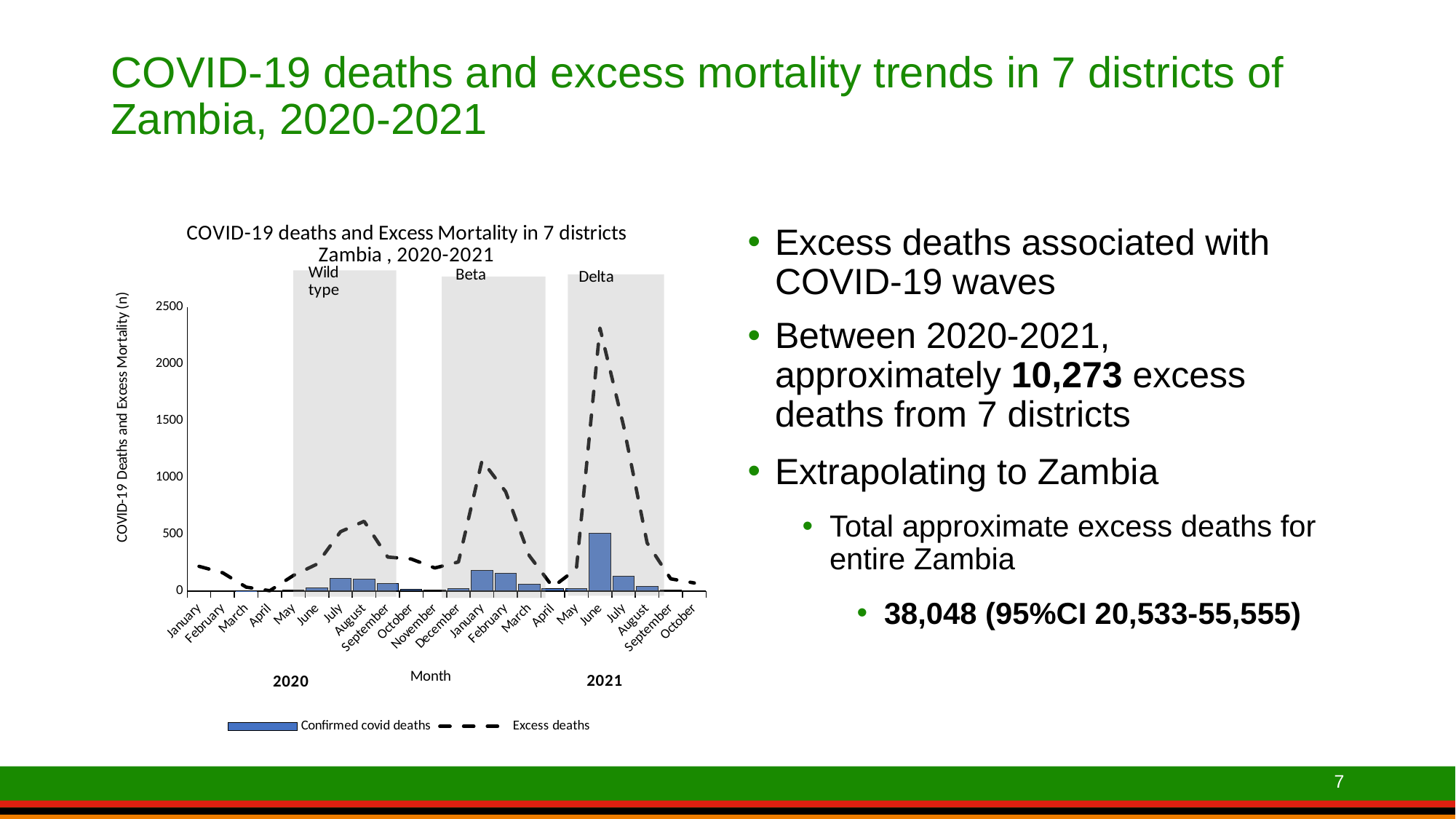
How many series does the chart legend list? 2 Which month has the larger Confirmed covid deaths bar, July 2020 or June 2021? June 2021 In which month does the Excess deaths line reach its peak? June 2021 Is the Excess deaths value for June 2021 greater or less than 2000? greater What are the two series named in the chart legend? Confirmed covid deaths and Excess deaths What kind of chart is shown on the slide? A combined bar and line chart Which month has the larger Excess deaths value, January 2021 or June 2021? June 2021 What are the three variant waves labelled by the shaded regions on the chart? Wild type, Beta, Delta Is the Excess deaths value for January 2021 greater or less than 500? greater How many months are plotted along the x axis of the chart? 22 Is the Excess deaths value for August 2020 greater or less than 500? greater In which month is the Confirmed covid deaths bar highest? June 2021